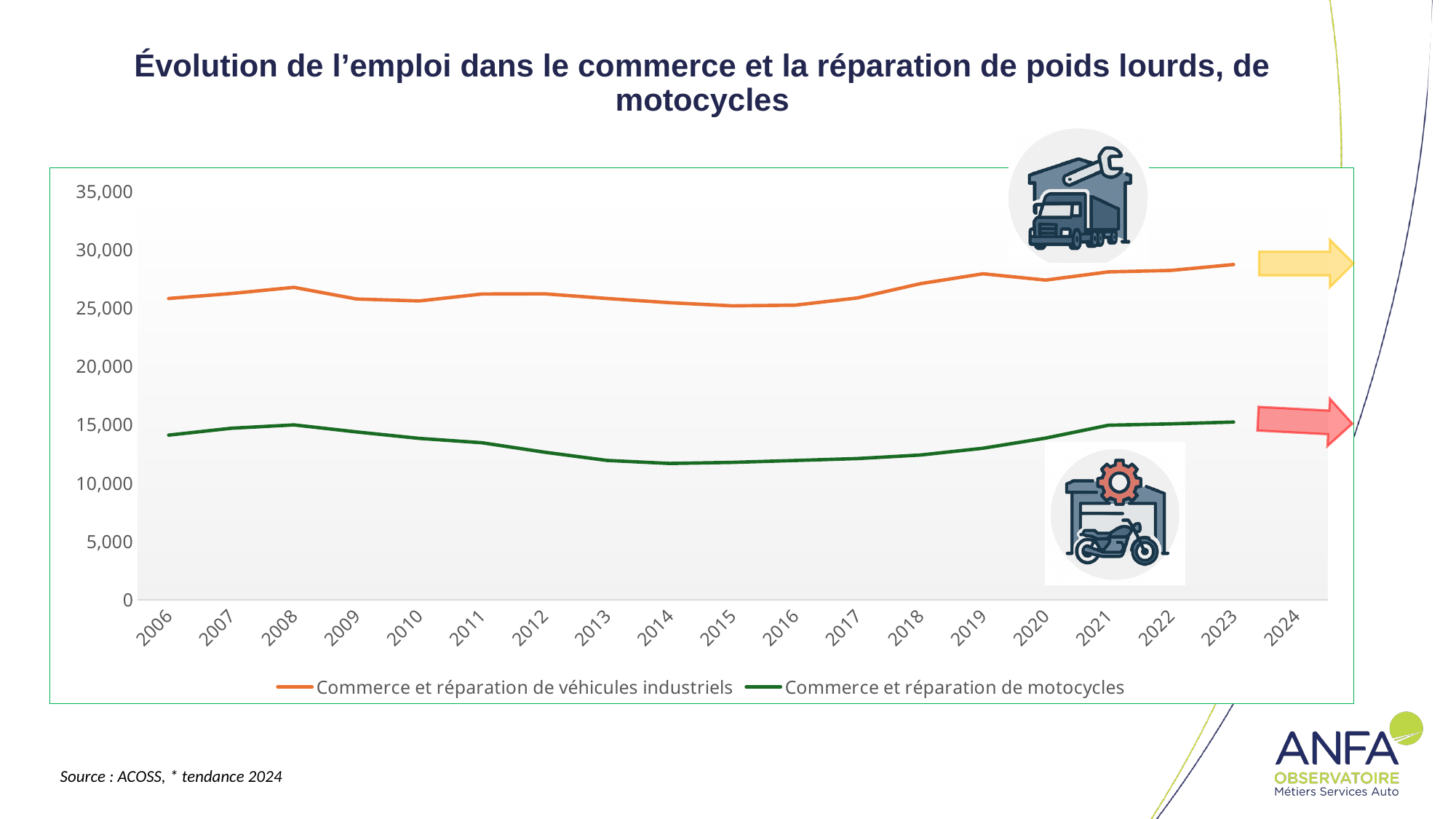
Does the Commerce et réparation de motocycles line rise or fall between 2008 and 2014? fall Does the Commerce et réparation de véhicules industriels line rise or fall between 2016 and 2023? rise Is the value for Commerce et réparation de motocycles in 2014 greater or less than 15,000? less What kind of chart is shown on the slide? line chart How many years are labelled on the x axis? 19 Is the value for Commerce et réparation de véhicules industriels in 2023 greater or less than 30,000? less Is the value for Commerce et réparation de véhicules industriels in 2023 greater or less than 25,000? greater How many series does the legend list? 2 What is the source cited below the chart? ACOSS Which series is plotted in orange? Commerce et réparation de véhicules industriels In 2010, which series has the higher value: Commerce et réparation de véhicules industriels or Commerce et réparation de motocycles? Commerce et réparation de véhicules industriels